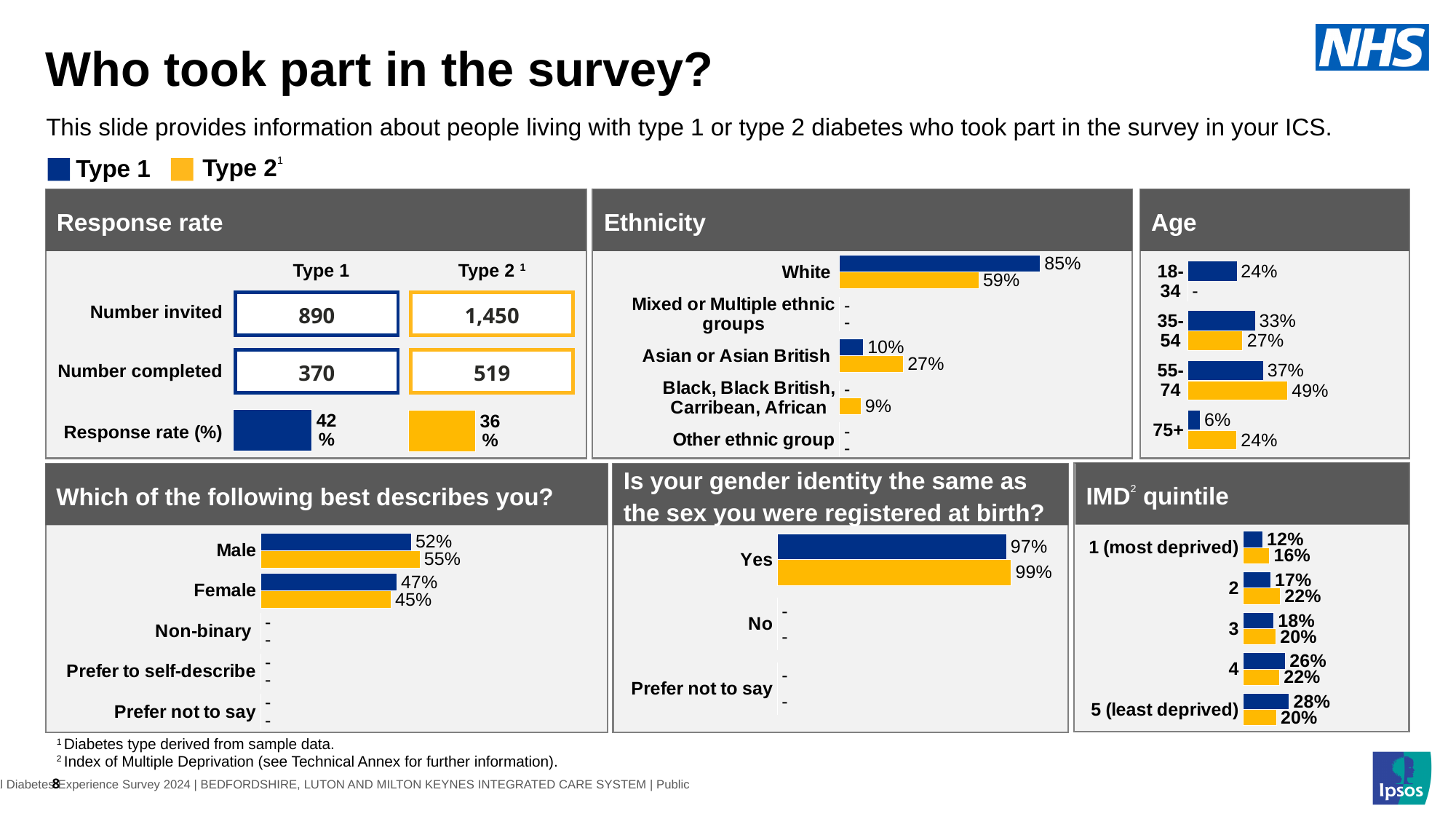
In the Response rate panel, what is the number completed for Type 2? 519 In the Age chart, what is the Type 2 value for the 55-74 age group? 49% In the Age chart, which age group has the highest Type 1 value? 55-74 In the chart 'Which of the following best describes you?', is the Type 1 value larger for Male or Female? Male How many series does the legend at the top of the slide list? 2 In the Ethnicity chart, what is the Type 1 value for White? 85% In the IMD quintile chart, which quintile has the lowest Type 1 value? 1 (most deprived) In the Ethnicity chart, what is the Type 2 value for Asian or Asian British? 27% In the chart 'Is your gender identity the same as the sex you were registered at birth?', what is the Type 2 value for Yes? 99% How many categories are shown in the chart 'Which of the following best describes you?' 5 In the IMD quintile chart, what is the Type 1 value for 5 (least deprived)? 28% In the Age chart, what is the difference between the Type 2 and Type 1 values for the 75+ age group? 18 percentage points